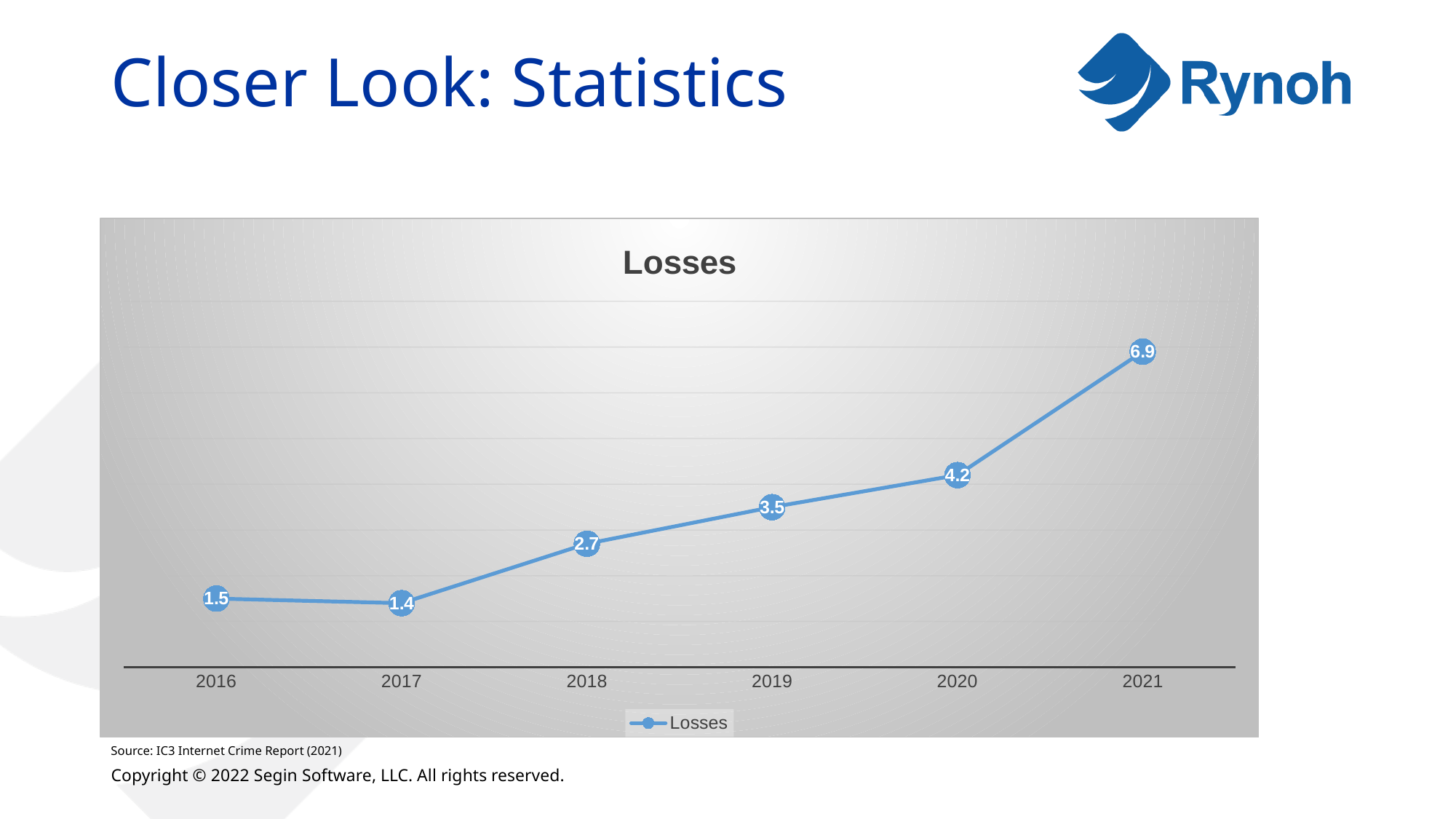
Do the Losses values generally rise or fall from 2017 to 2021? Rise How many years are plotted on the x axis? 6 What is the value for Losses in 2021? 6.9 Which year has the lowest Losses value? 2017 How many series does the legend list? 1 What is the difference between the Losses values for 2019 and 2018? 0.8 Which year has a larger Losses value, 2019 or 2020? 2020 What is the value for Losses in 2016? 1.5 What kind of chart is shown on the slide? Line chart What is the difference between the Losses values for 2021 and 2020? 2.7 Which year has the highest Losses value? 2021 What is the value for Losses in 2018? 2.7